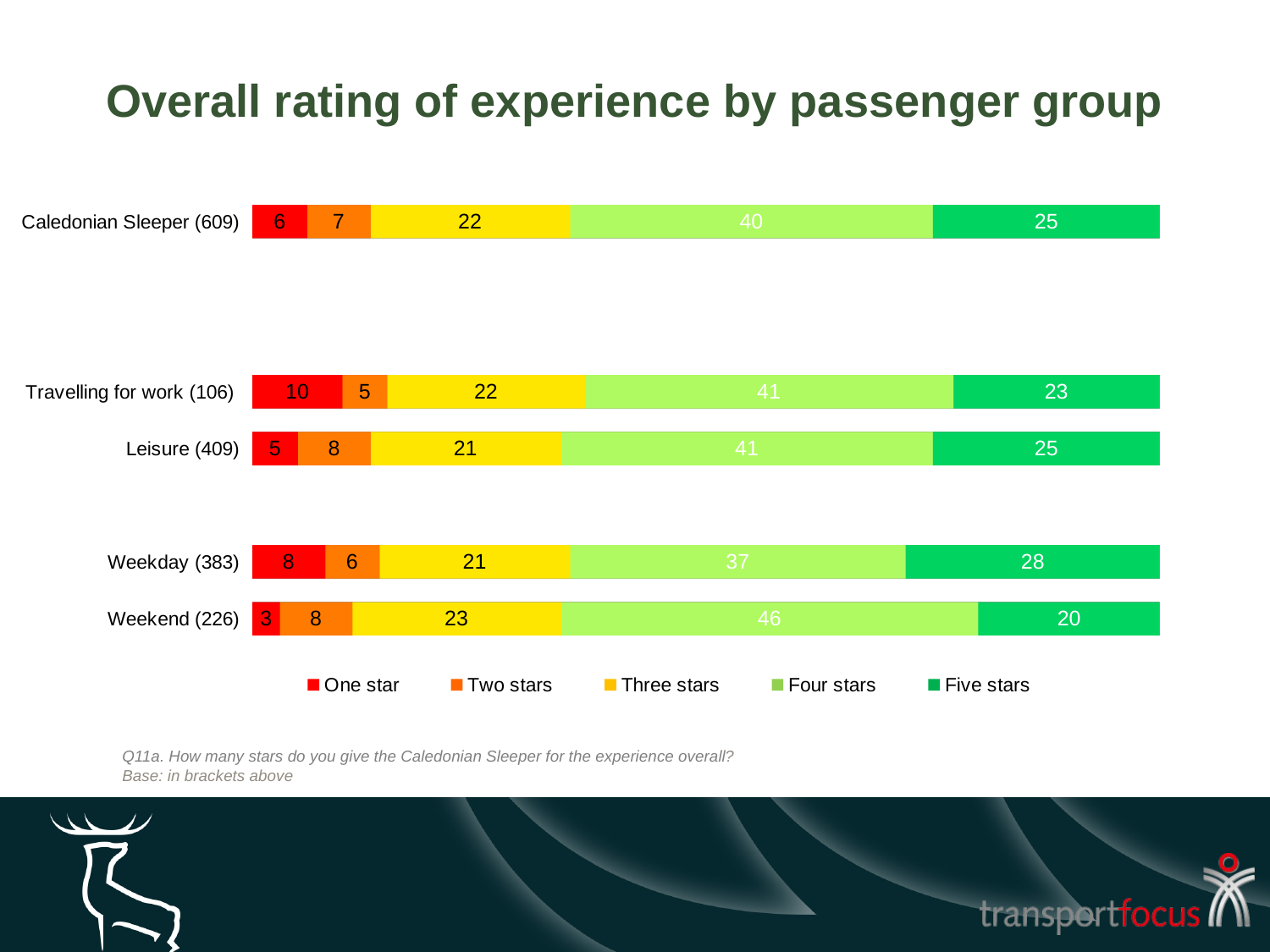
What is the Four stars value for Weekend (226)? 46 What is the Five stars value for Weekday (383)? 28 Which passenger group has the lowest One star value? Weekend (226) What kind of chart is shown on the slide? Stacked bar chart How many series does the legend list? 5 What is the total of the stacked bar for Caledonian Sleeper (609)? 100 Which is larger: the Five stars value for Leisure (409) or for Travelling for work (106)? Leisure (409) What is the difference between the Four stars values for Weekend (226) and Weekday (383)? 9 Which passenger group has the highest Five stars value? Weekday (383) What is the One star value for Travelling for work (106)? 10 How many passenger groups are shown in the chart? 5 What is the Three stars value for Caledonian Sleeper (609)? 22